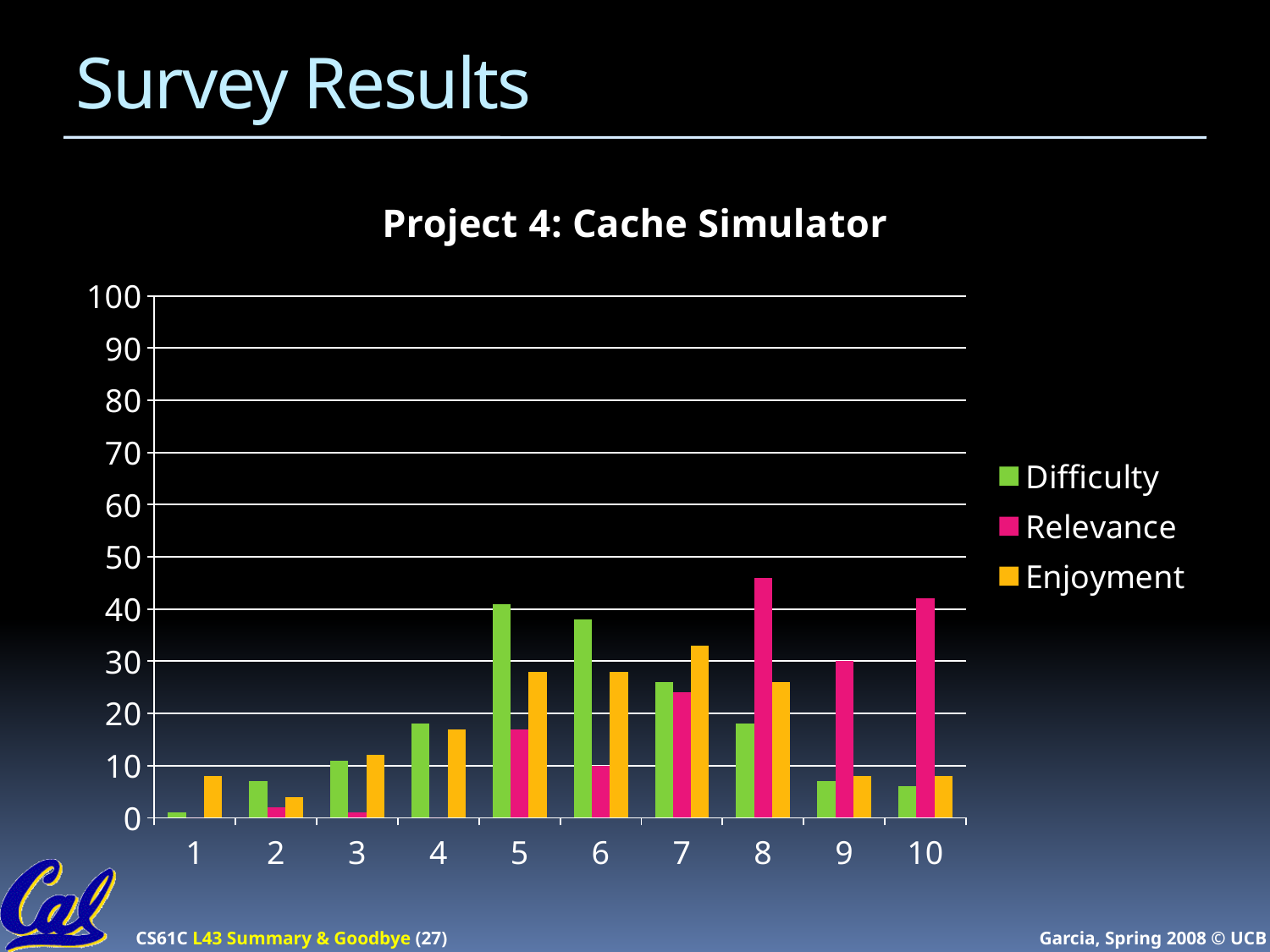
What is the title of the chart? Project 4: Cache Simulator How many series does the legend list? 3 Which category has the highest Relevance value? 8 Is the Relevance value for category 8 greater or less than 40? greater How many categories are shown on the x axis? 10 For category 5, which is larger: Difficulty or Relevance? Difficulty What kind of chart is shown on the slide? bar chart Is the Difficulty value for category 5 greater or less than 30? greater For category 8, which is larger: Difficulty or Relevance? Relevance Which category has the highest Enjoyment value? 7 Is the Enjoyment value for category 7 greater or less than 30? greater